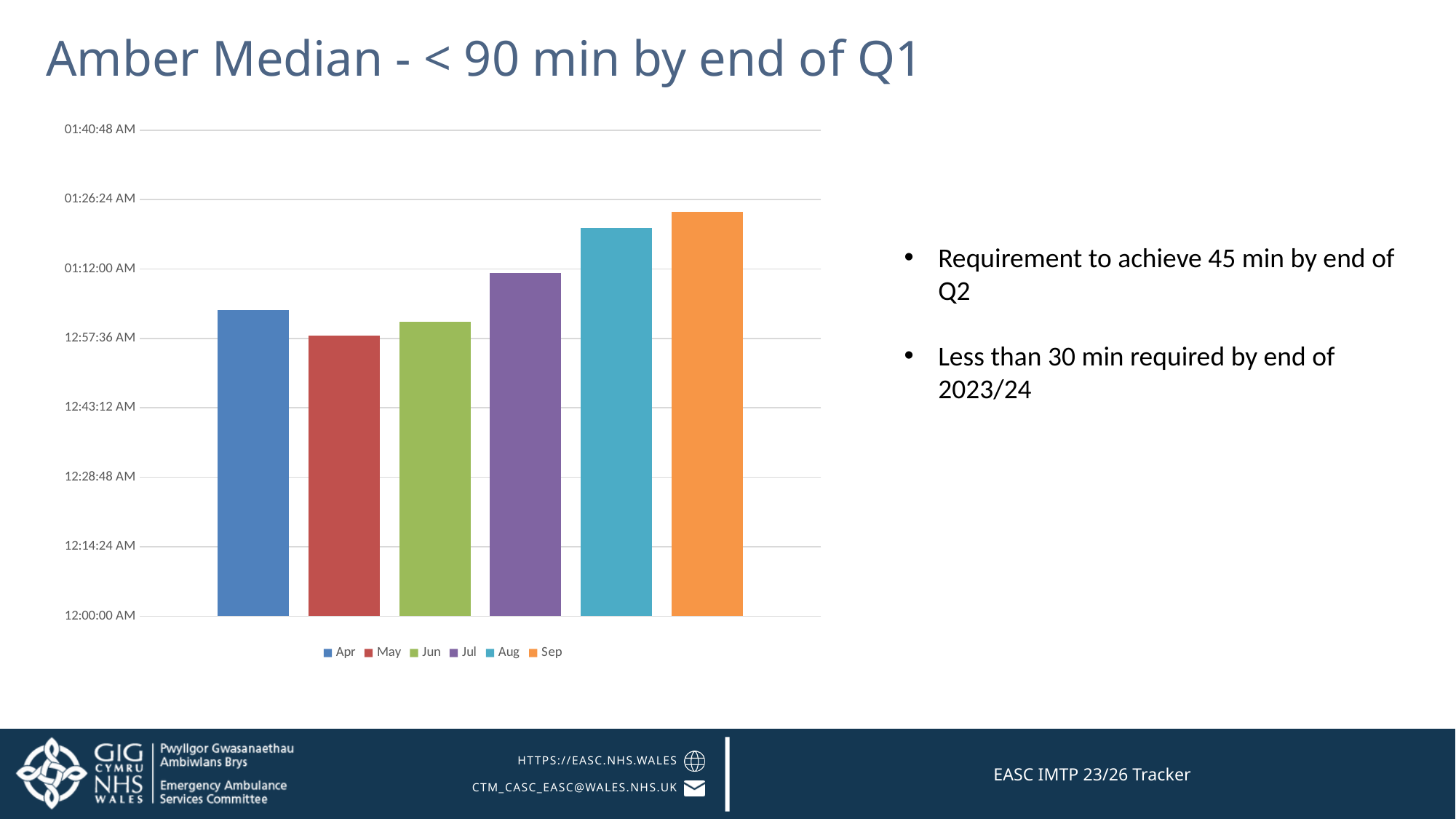
Which month has the lowest bar in the chart? May Which month has the highest bar in the chart? Sep Which is larger, the value for Aug or the value for Jul? Aug What is the title of the slide containing the chart? Amber Median - < 90 min by end of Q1 Is the value for May greater or less than 01:12:00 AM? less How many entries does the chart legend list? 6 Do the bar values rise or fall from Jun through Sep? Rise Which is larger, the value for Apr or the value for Jun? Apr Is the value for Sep greater or less than 01:12:00 AM? greater What kind of chart is shown on the slide? Bar chart How many bars are plotted in the chart? 6 Is the value for Aug greater or less than 01:26:24 AM? less